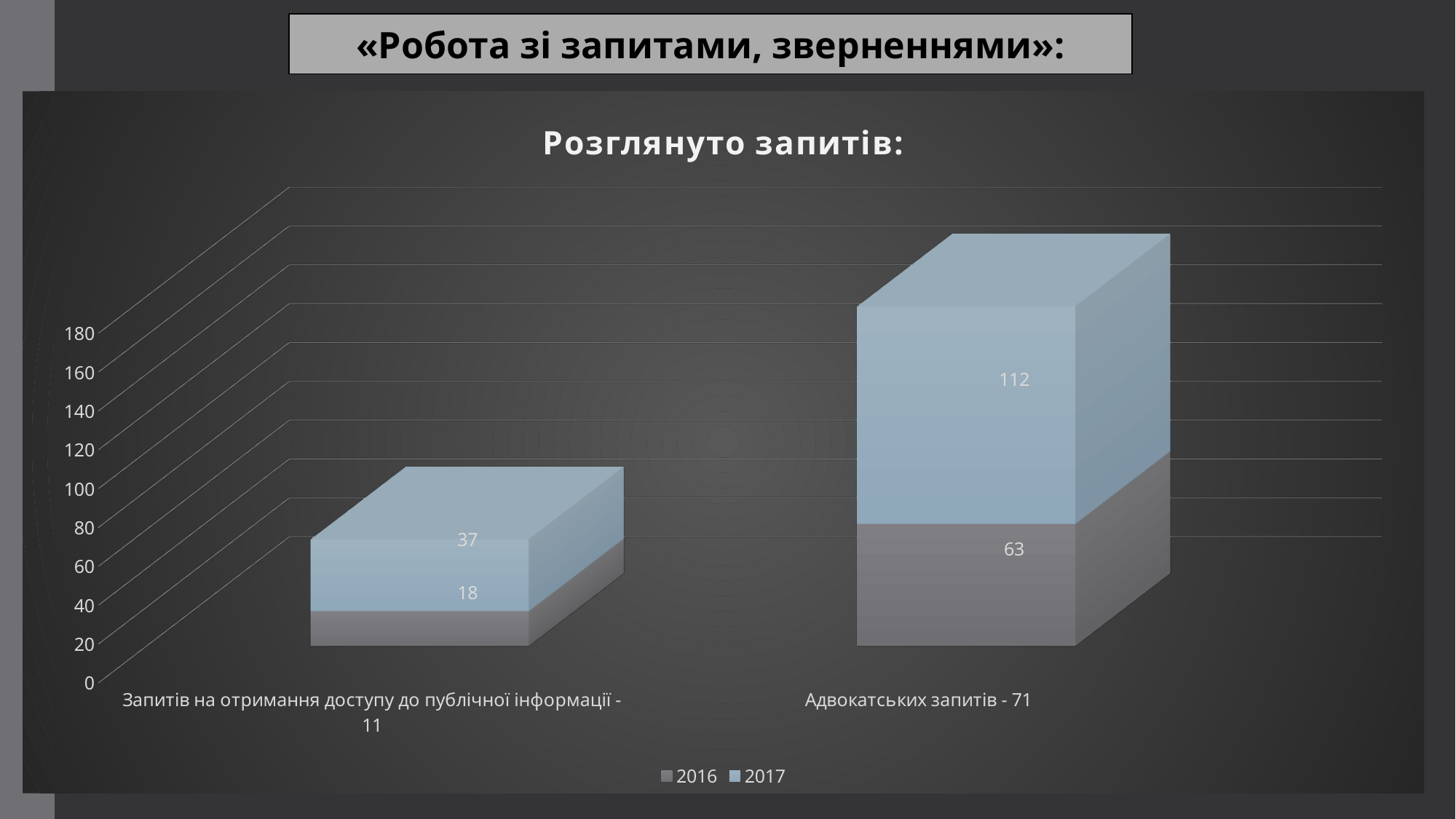
What is the 2016 value for "Адвокатських запитів - 71"? 63 How many categories are shown on the x axis? 2 What is the total of the stacked bar for "Адвокатських запитів - 71"? 175 How many series does the legend list? 2 What is the 2017 value for "Адвокатських запитів - 71"? 112 Which category has the higher 2017 value? Адвокатських запитів - 71 What is the difference between the 2017 and 2016 values for "Адвокатських запитів - 71"? 49 What is the 2017 value for "Запитів на отримання доступу до публічної інформації - 11"? 37 What is the 2016 value for "Запитів на отримання доступу до публічної інформації - 11"? 18 What is the title of the chart? Розглянуто запитів: What type of chart is shown on the slide? Stacked bar chart What is the total of the stacked bar for "Запитів на отримання доступу до публічної інформації - 11"? 55